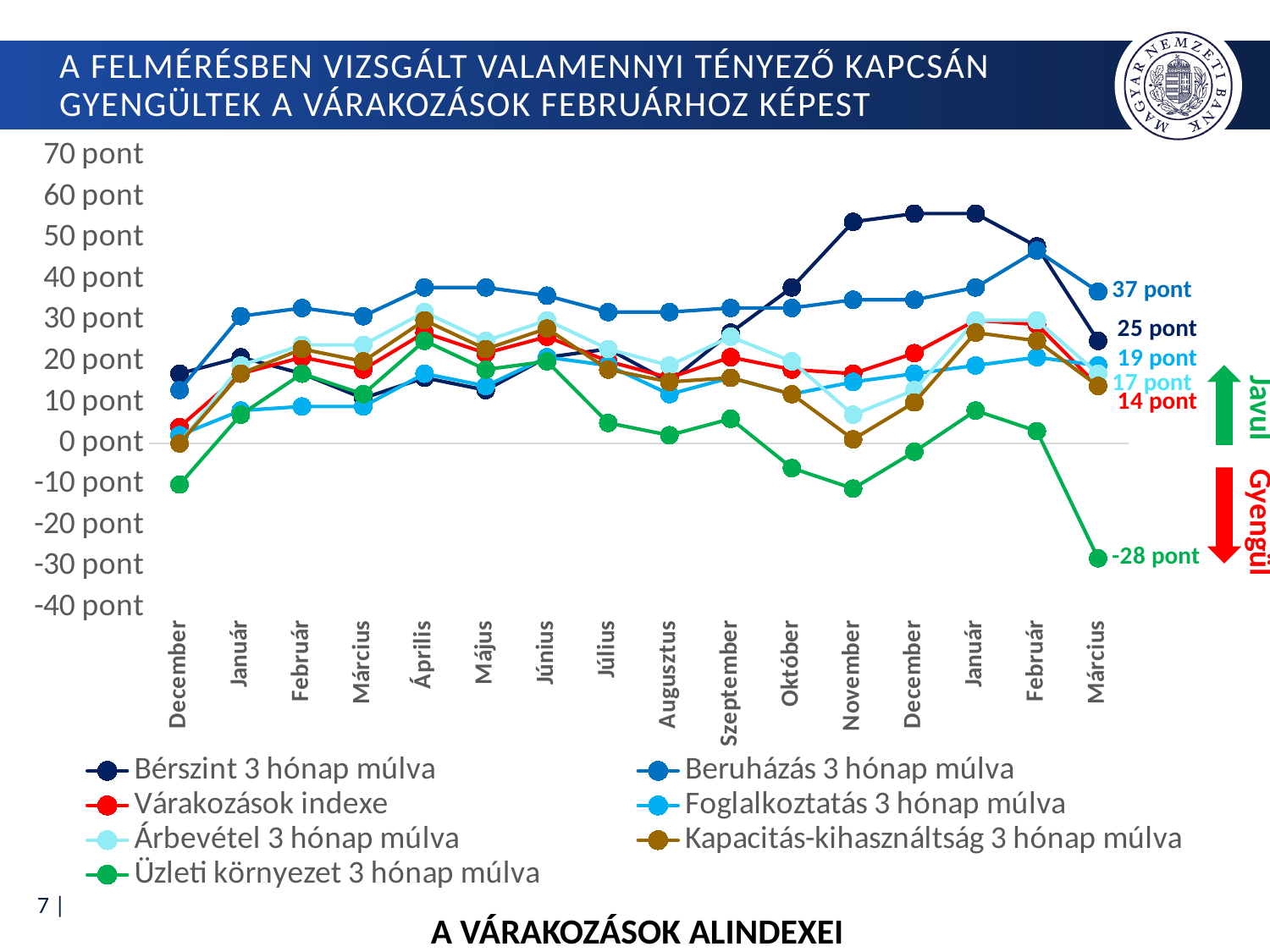
Which series has the highest value in the final Március? Beruházás 3 hónap múlva What is the value of Bérszint 3 hónap múlva in the final Március? 25 pont Which series has the lowest value in the final Március? Üzleti környezet 3 hónap múlva What kind of chart is shown on the slide? line chart Is the value for Bérszint 3 hónap múlva in November greater or less than 50 pont? greater How many months are shown along the x axis? 16 What is the difference between Beruházás 3 hónap múlva and Üzleti környezet 3 hónap múlva in the final Március? 65 pont In the final Március, which is larger: Beruházás 3 hónap múlva or Bérszint 3 hónap múlva? Beruházás 3 hónap múlva How many series does the legend list? 7 What is the value of Üzleti környezet 3 hónap múlva in the final Március? -28 pont What is the title printed below the chart? A VÁRAKOZÁSOK ALINDEXEI What is the value of Beruházás 3 hónap múlva in the final Március? 37 pont